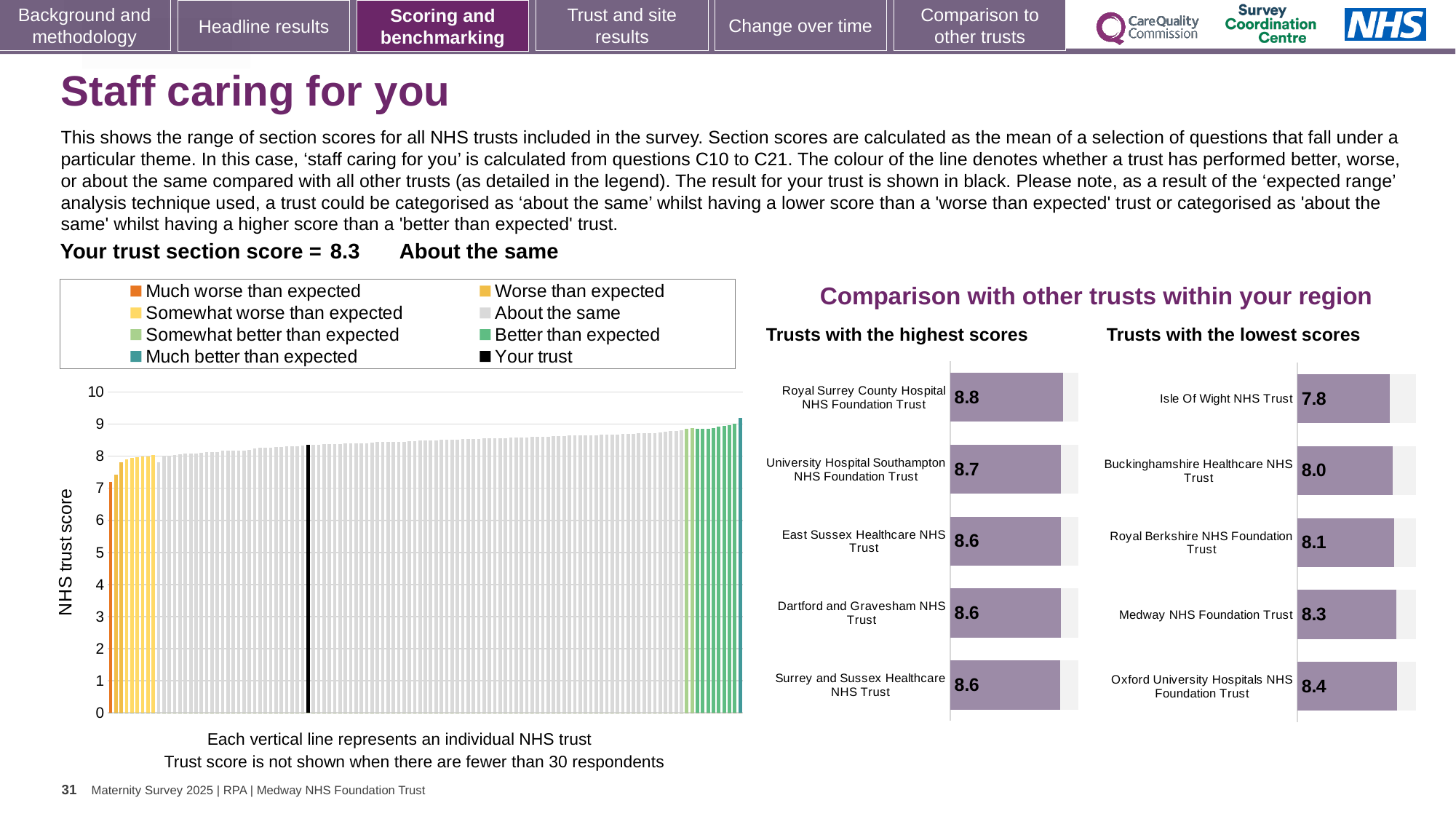
In the 'Trusts with the highest scores' chart, which trust has the highest score? Royal Surrey County Hospital NHS Foundation Trust In the main 'NHS trust score' chart on the left, do the bar values rise or fall from left to right? rise In the 'Trusts with the lowest scores' chart, which trust has the lowest score? Isle Of Wight NHS Trust In the 'Trusts with the highest scores' chart, what is the score for Royal Surrey County Hospital NHS Foundation Trust? 8.8 How many trusts are shown in the 'Trusts with the highest scores' chart? 5 In the 'Trusts with the lowest scores' chart, what is the score for Medway NHS Foundation Trust? 8.3 In the 'Trusts with the lowest scores' chart, what is the score for Isle Of Wight NHS Trust? 7.8 What kind of chart is the main 'NHS trust score' chart on the left of the slide? bar chart How many entries does the legend of the main 'NHS trust score' chart on the left list? 8 In the 'Trusts with the lowest scores' chart, which has the higher score: Buckinghamshire Healthcare NHS Trust or Royal Berkshire NHS Foundation Trust? Royal Berkshire NHS Foundation Trust In the 'Trusts with the lowest scores' chart, is the value for Medway NHS Foundation Trust greater or less than 8? greater In the 'Trusts with the lowest scores' chart, what is the difference between the scores of Oxford University Hospitals NHS Foundation Trust and Isle Of Wight NHS Trust? 0.6